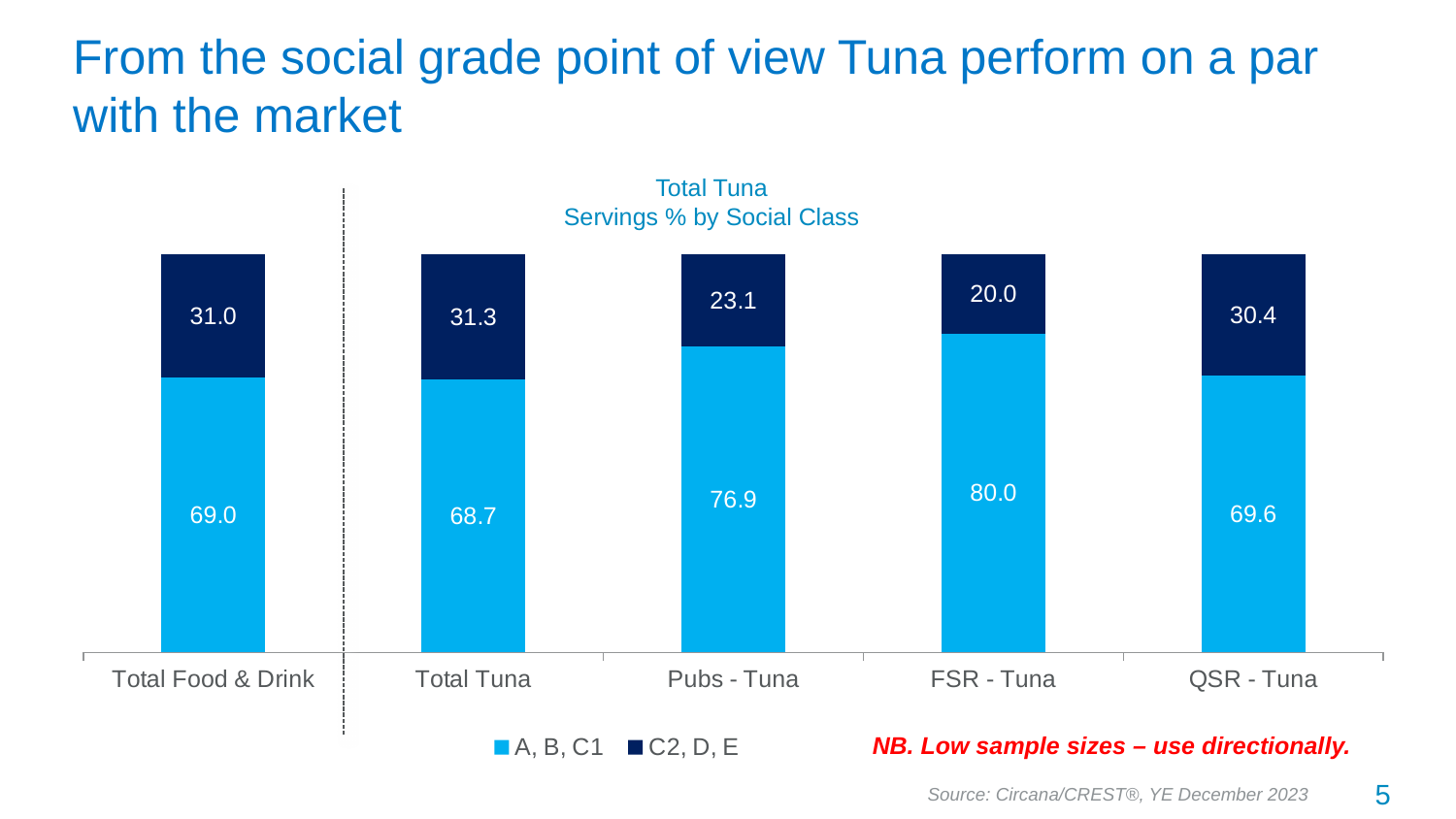
How many series does the legend list? 2 Which category has the lowest C2, D, E value? FSR - Tuna What is the A, B, C1 value for FSR - Tuna? 80.0 What is the A, B, C1 value for Total Food & Drink? 69.0 Which is larger, the C2, D, E value for Total Food & Drink or for QSR - Tuna? Total Food & Drink What is the total of the stacked bar for Pubs - Tuna? 100.0 Which category has the highest A, B, C1 value? FSR - Tuna What is the C2, D, E value for Total Tuna? 31.3 What kind of chart is shown? Stacked bar chart How many categories are shown on the x axis? 5 What is the difference between the A, B, C1 values for Pubs - Tuna and QSR - Tuna? 7.3 What is the title of the chart? Total Tuna Servings % by Social Class